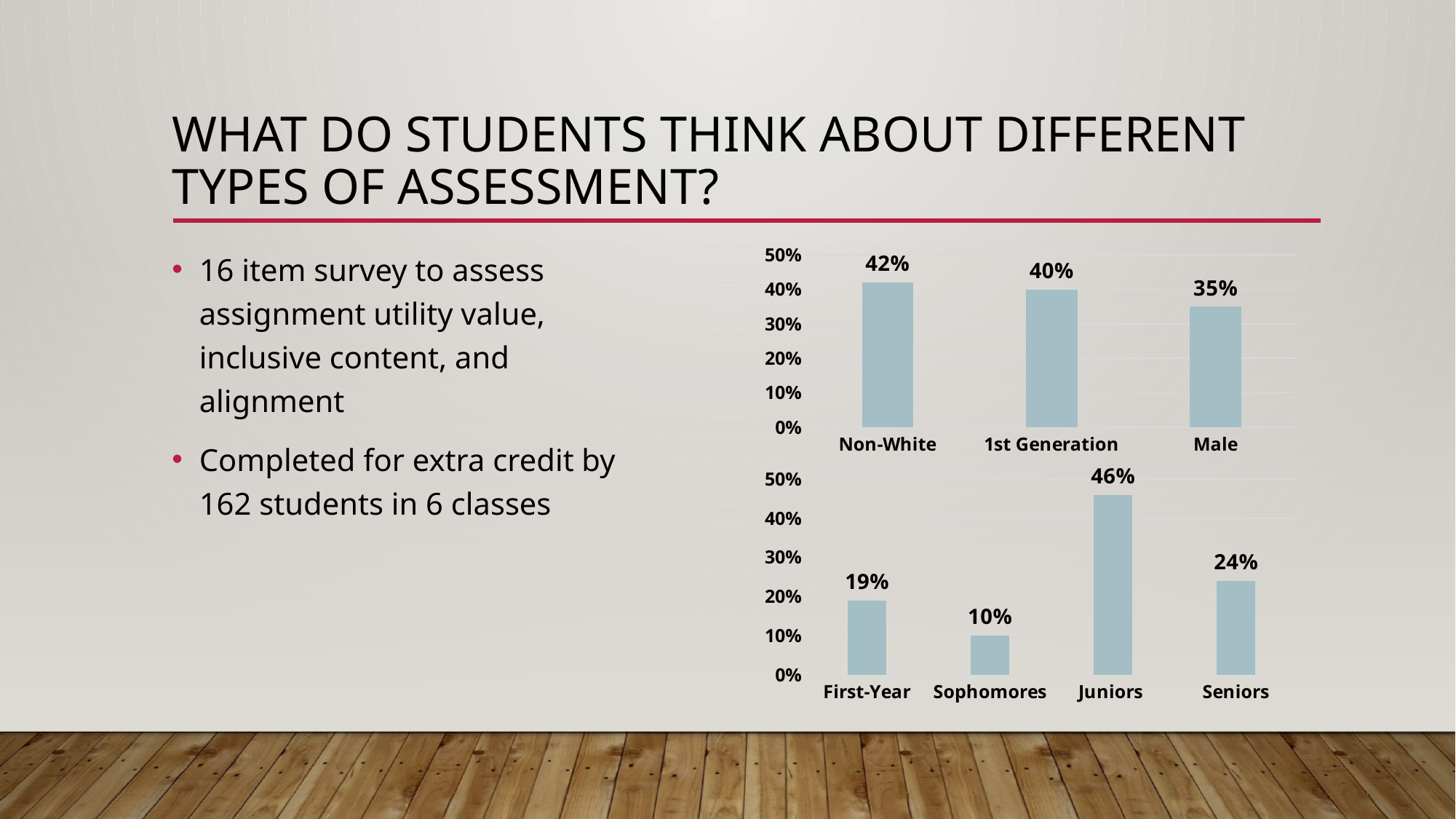
In the bottom chart, what is the value for Sophomores? 10% How many categories are shown in the bottom chart? 4 What kind of chart is the top chart? Bar chart In the top chart, which category has the lowest value? Male In the bottom chart, which is larger, the value for Seniors or the value for First-Year? Seniors In the bottom chart, what is the value for Seniors? 24% In the bottom chart, which category has the lowest value? Sophomores In the bottom chart, which category has the highest value? Juniors In the top chart, what is the difference between the values for Non-White and Male? 7% In the top chart, what is the value for 1st Generation? 40% In the top chart, what is the value for Non-White? 42% In the bottom chart, what is the difference between the values for Juniors and First-Year? 27%